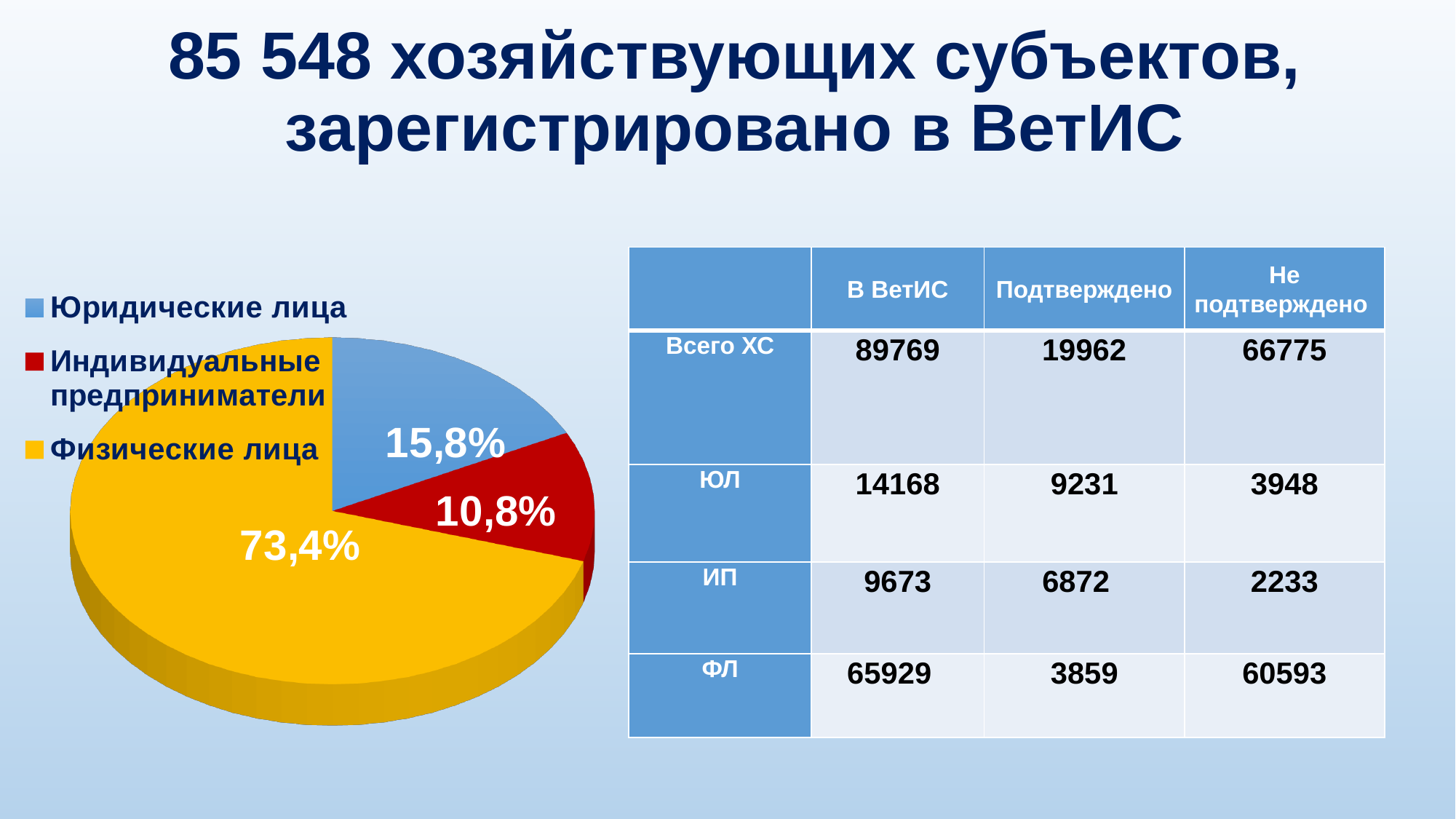
What is the difference in percentage points between the Физические лица slice and the Юридические лица slice? 57,6 What colour is the Физические лица slice in the pie chart? yellow Which category has the largest slice in the pie chart? Физические лица What share of the pie chart is labelled for Юридические лица? 15,8% How many slices does the pie chart have? 3 What kind of chart is shown on the slide? pie chart What share of the pie chart is labelled for Физические лица? 73,4% Which category has the smallest slice in the pie chart? Индивидуальные предприниматели How many entries does the pie chart legend list? 3 Which slice is larger in the pie chart: Юридические лица or Индивидуальные предприниматели? Юридические лица What colour is the Индивидуальные предприниматели slice in the pie chart? red What share of the pie chart is labelled for Индивидуальные предприниматели? 10,8%